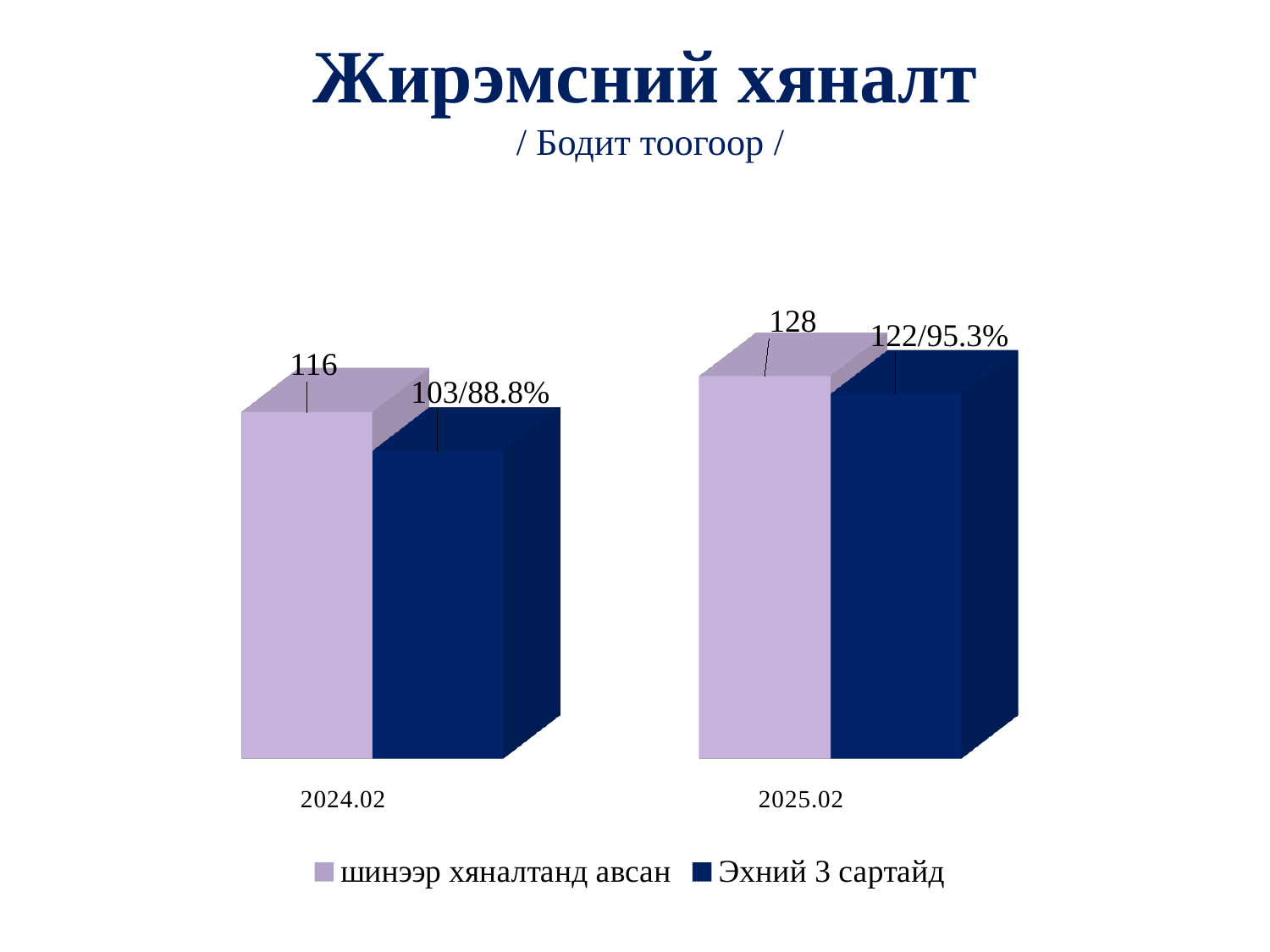
In 2024.02, what is the difference between "шинээр хяналтанд авсан" (116) and the "Эхний 3 сартайд" count (103)? 13 What kind of chart is shown on the slide? Bar chart What is the value for "шинээр хяналтанд авсан" in 2025.02? 128 What data label is shown for "Эхний 3 сартайд" in 2024.02? 103/88.8% What data label is shown for "Эхний 3 сартайд" in 2025.02? 122/95.3% What is the difference between the "шинээр хяналтанд авсан" values for 2025.02 and 2024.02? 12 What is the value for "шинээр хяналтанд авсан" in 2024.02? 116 Which year has the higher value for "шинээр хяналтанд авсан"? 2025.02 How many categories are shown on the x axis? 2 Is the "Эхний 3 сартайд" count larger in 2024.02 or 2025.02? 2025.02 How many series does the legend list? 2 Which year has the lower count for "Эхний 3 сартайд"? 2024.02